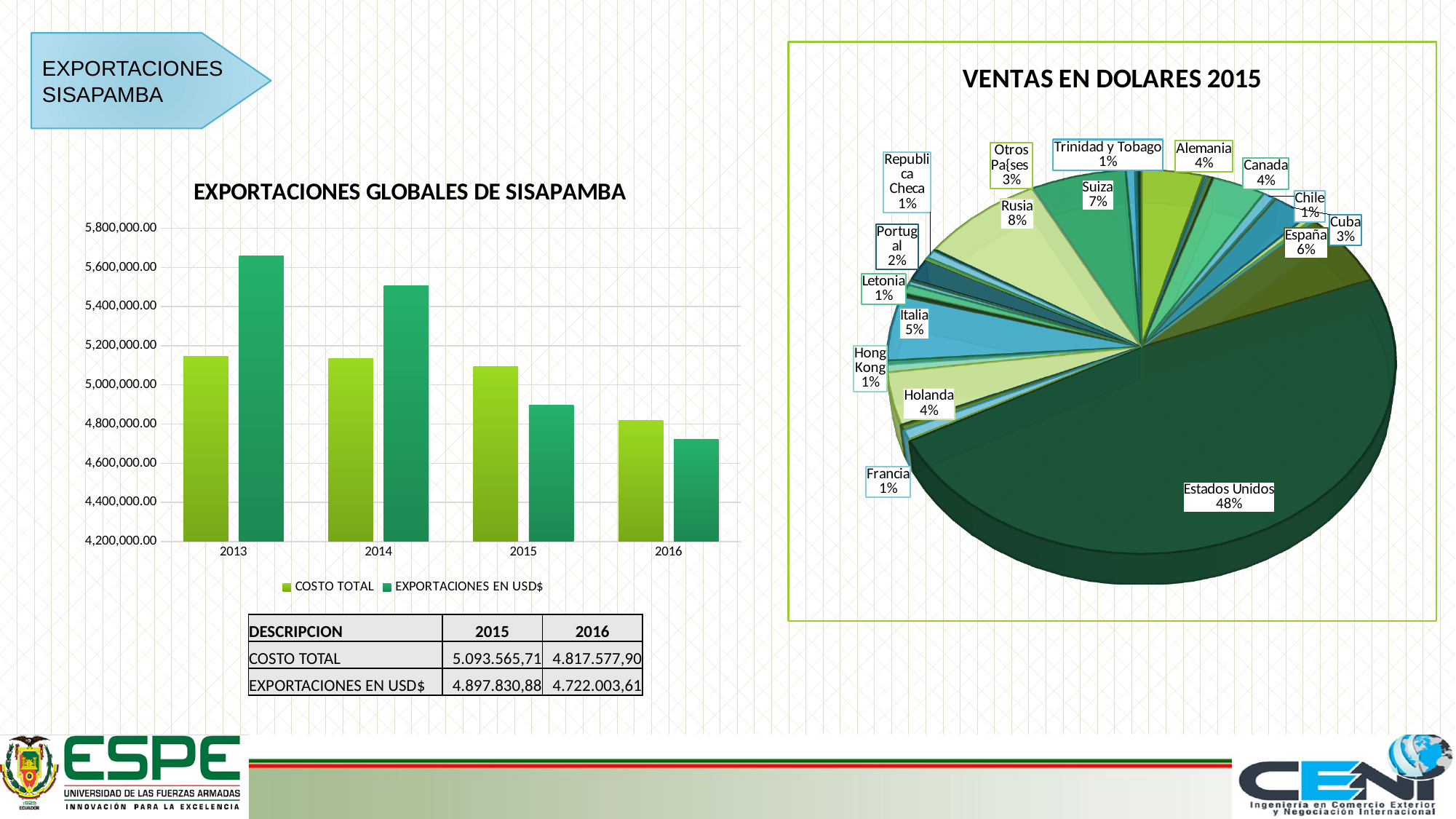
In the pie chart VENTAS EN DOLARES 2015, what share does Rusia have? 8% In the pie chart VENTAS EN DOLARES 2015, which country has the largest slice? Estados Unidos In the chart EXPORTACIONES GLOBALES DE SISAPAMBA, which is larger for 2013, COSTO TOTAL or EXPORTACIONES EN USD$? EXPORTACIONES EN USD$ In the chart EXPORTACIONES GLOBALES DE SISAPAMBA, does the COSTO TOTAL series rise or fall from 2013 to 2016? Fall In the chart EXPORTACIONES GLOBALES DE SISAPAMBA, is the EXPORTACIONES EN USD$ value for 2016 greater or less than 4,800,000.00? less In the pie chart VENTAS EN DOLARES 2015, what share does Estados Unidos have? 48% How many series does the legend of the chart EXPORTACIONES GLOBALES DE SISAPAMBA list? 2 In the chart EXPORTACIONES GLOBALES DE SISAPAMBA, is the EXPORTACIONES EN USD$ value for 2013 greater or less than 5,600,000.00? greater What kind of chart is EXPORTACIONES GLOBALES DE SISAPAMBA? Bar chart In the pie chart VENTAS EN DOLARES 2015, which is larger, the share for Suiza or the share for España? Suiza In the pie chart VENTAS EN DOLARES 2015, what is the difference between the shares of Rusia and Italia? 3%